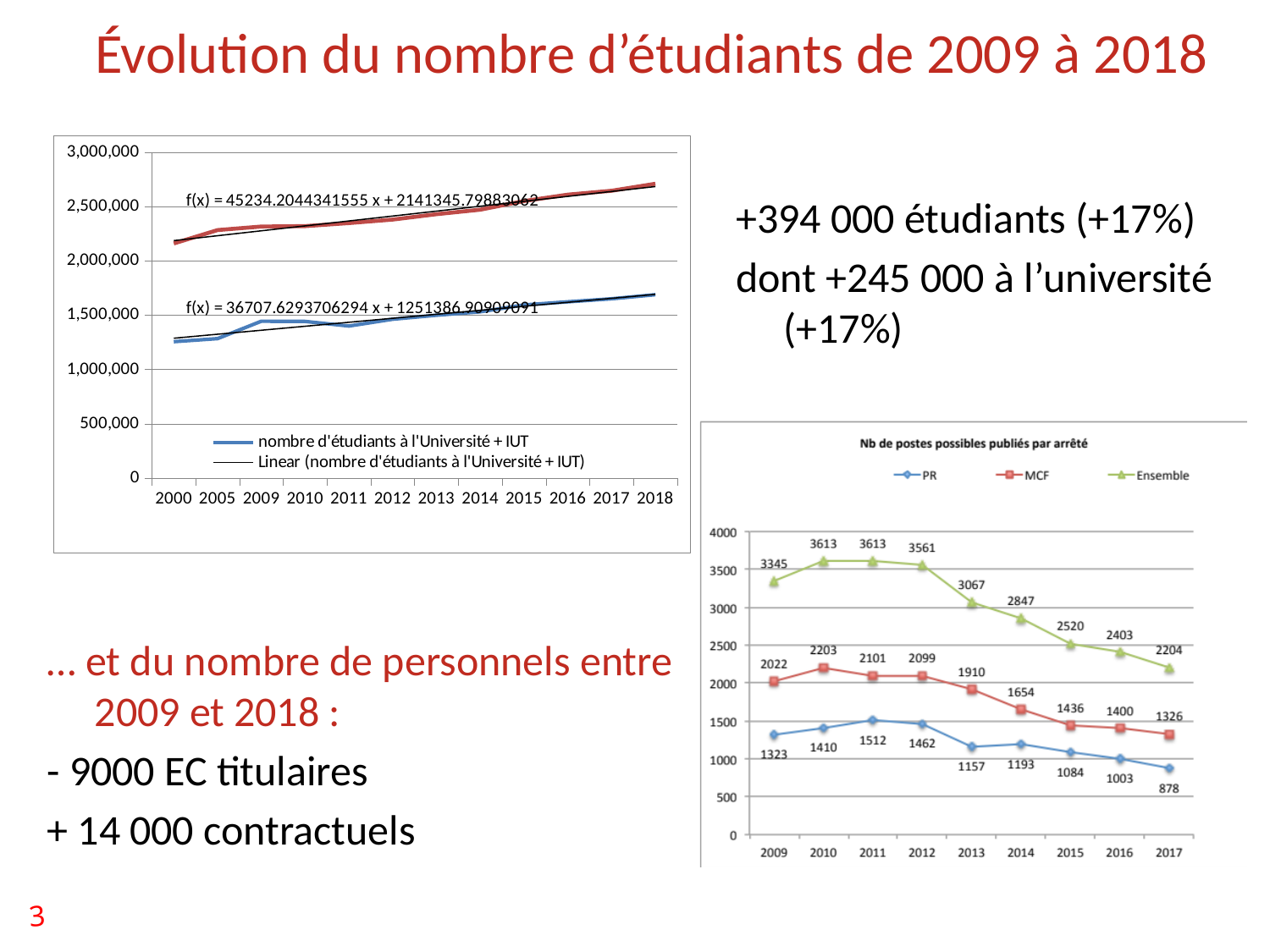
In the chart titled 'Nb de postes possibles publiés par arrêté', in which year is the PR series highest? 2011 In the chart titled 'Nb de postes possibles publiés par arrêté', by how much did the MCF value fall between 2009 and 2017? 696 In the chart titled 'Nb de postes possibles publiés par arrêté', what is the MCF value in 2010? 2203 How many years are shown on the x axis of the chart titled 'Nb de postes possibles publiés par arrêté'? 9 In the chart titled 'Nb de postes possibles publiés par arrêté', in which year is the Ensemble series lowest? 2017 What kind of chart is the top-left chart showing the number of students from 2000 to 2018? line chart In the top-left chart, is the 2018 value of 'nombre d'étudiants à l'Université + IUT' greater or less than 1,500,000? greater How many series does the legend of the chart titled 'Nb de postes possibles publiés par arrêté' list? 3 In the chart titled 'Nb de postes possibles publiés par arrêté', what is the value of the Ensemble series in 2013? 3067 In the chart titled 'Nb de postes possibles publiés par arrêté', does the Ensemble series generally rise or fall from 2010 to 2017? fall In the chart titled 'Nb de postes possibles publiés par arrêté', which is larger: the PR value in 2012 or in 2014? 2012 In the chart titled 'Nb de postes possibles publiés par arrêté', what is the PR value in 2017? 878